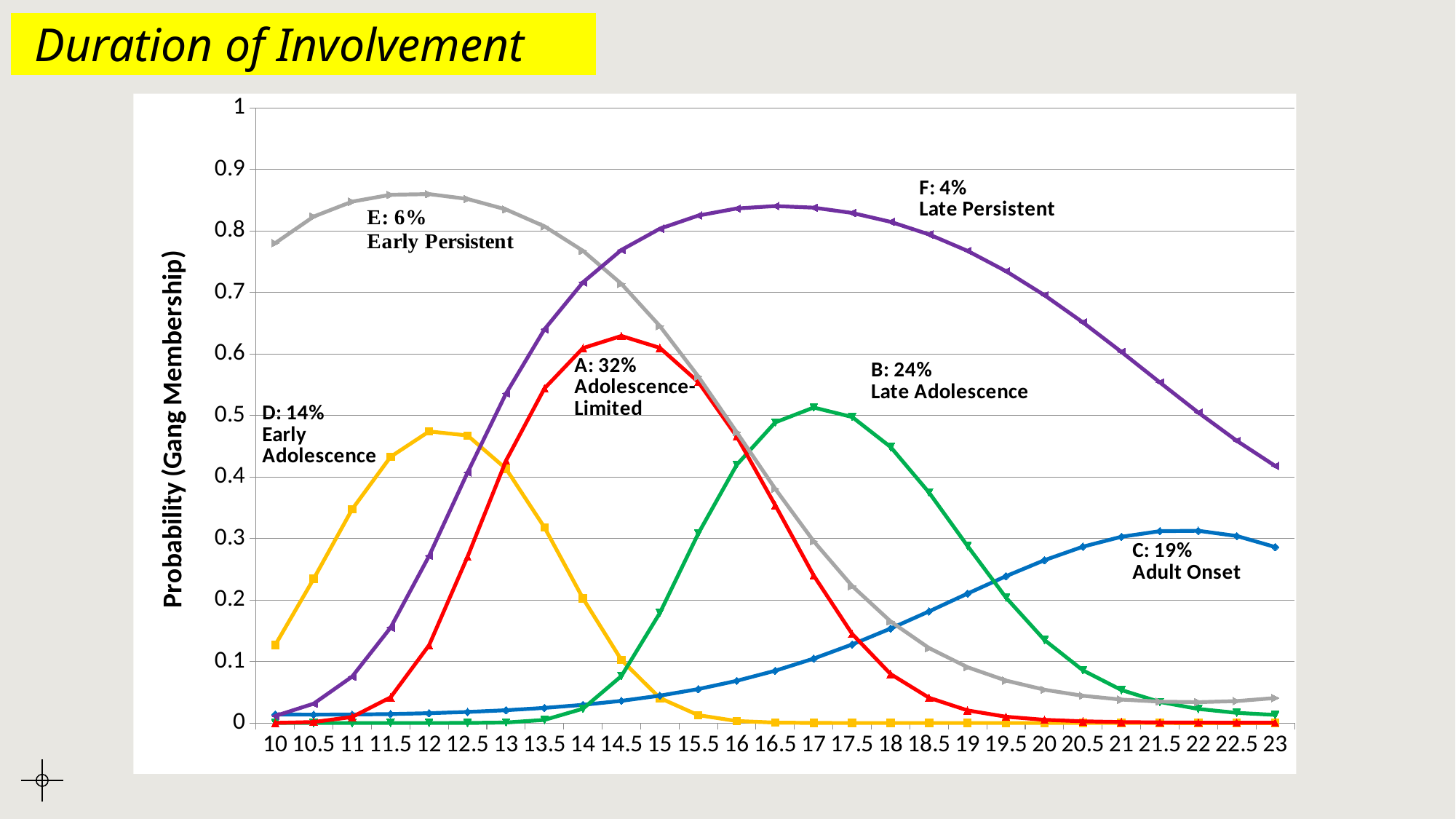
Is the value for D: Early Adolescence at age 12 greater or less than 0.5? less Is the value for F: Late Persistent at age 23 greater or less than 0.5? less Is the value for A: Adolescence-Limited at age 14.5 greater or less than 0.6? greater At age 12, which group has the higher probability, E: Early Persistent or D: Early Adolescence? E: Early Persistent Does the probability for C: Adult Onset rise or fall between age 10 and age 21.5? rise How many trajectory groups (series) are plotted on the chart? 6 What is the title of the y axis? Probability (Gang Membership) What percentage is shown for group A: Adolescence-Limited? 32% What kind of chart is shown on the slide? line chart Which group has the lowest peak probability on the chart? C: Adult Onset